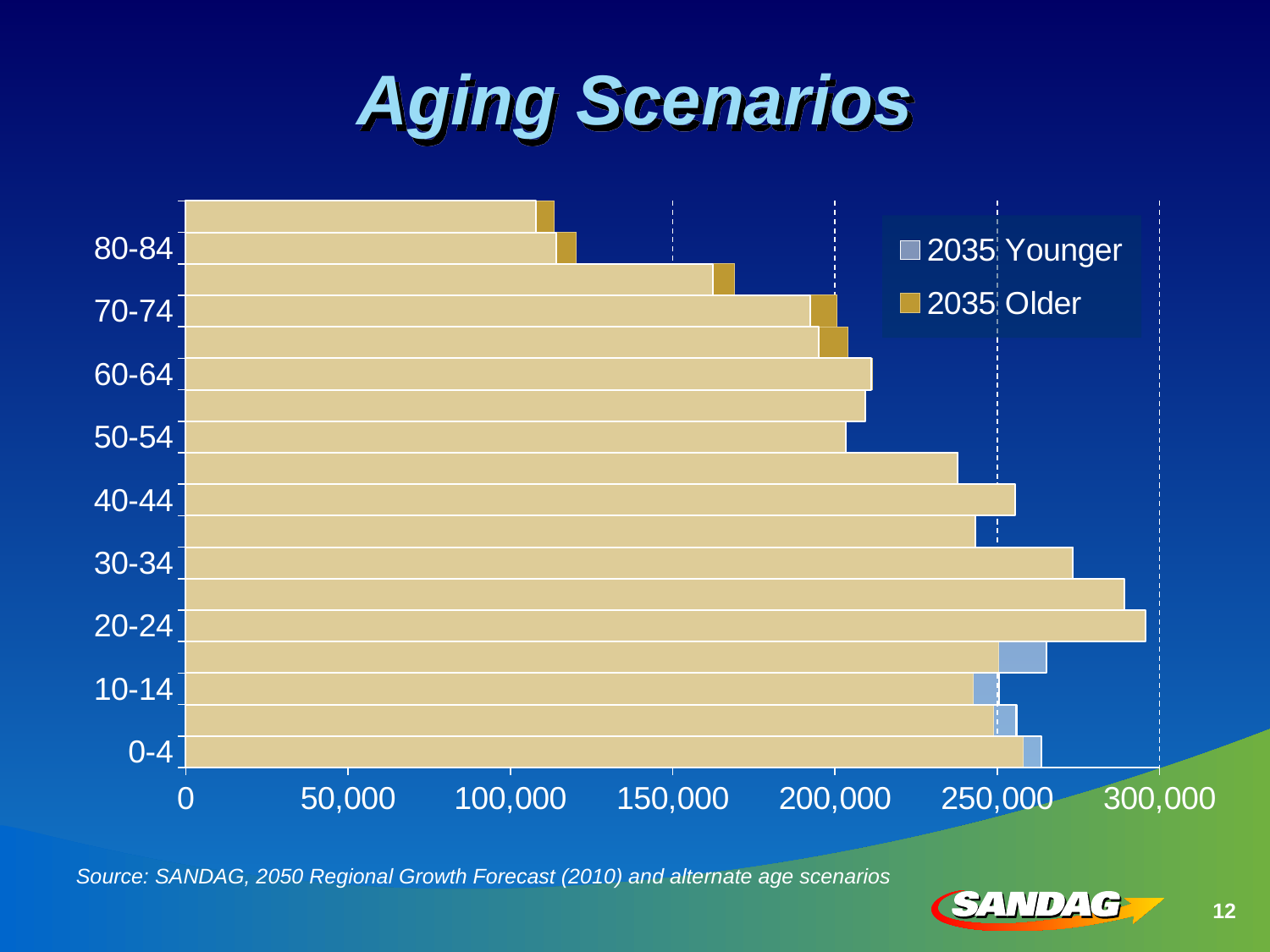
Which labeled age group has the longest bar? 20-24 What is the title of the chart? Aging Scenarios Is the value for the 80-84 age group greater or less than 150,000? less Which labeled age group has the shortest bar? 80-84 How many age group labels are shown on the vertical axis? 9 Is the value for the 20-24 age group greater or less than 250,000? greater What type of chart is shown on the slide? Bar chart Moving up the axis from the 20-24 age group to the 80-84 age group, do the bars get longer or shorter? shorter What are the two series named in the legend? 2035 Younger and 2035 Older Is the value for the 30-34 age group greater or less than 250,000? greater How many series does the legend list? 2 Which has the larger value, the 20-24 age group or the 80-84 age group? 20-24